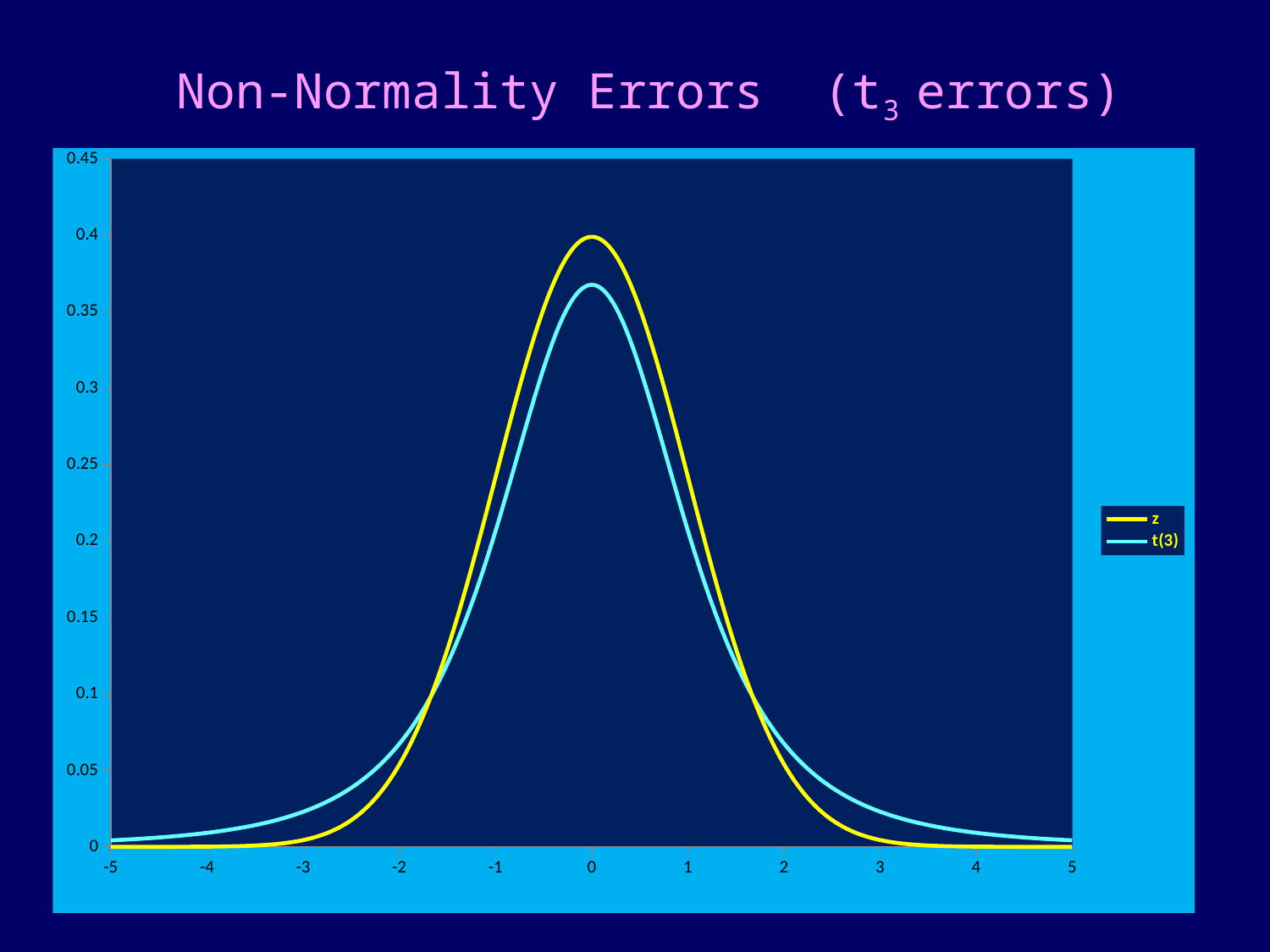
Is the peak value of the t(3) series at x = 0 greater or less than 0.4? less Is the value of the t(3) series at x = 2 greater or less than 0.05? greater Is the peak value of the z series at x = 0 greater or less than 0.35? greater At x = 3, which series has the higher value, z or t(3)? t(3) What are the two series named in the legend? z and t(3) Which colour is used for the z series? yellow At x = 0, which series has the higher value, z or t(3)? z How many series does the legend list? 2 How many tick labels are shown on the x axis? 11 Do the values of the z series rise or fall as x goes from 0 to 5? fall What kind of chart is shown on the slide? line chart